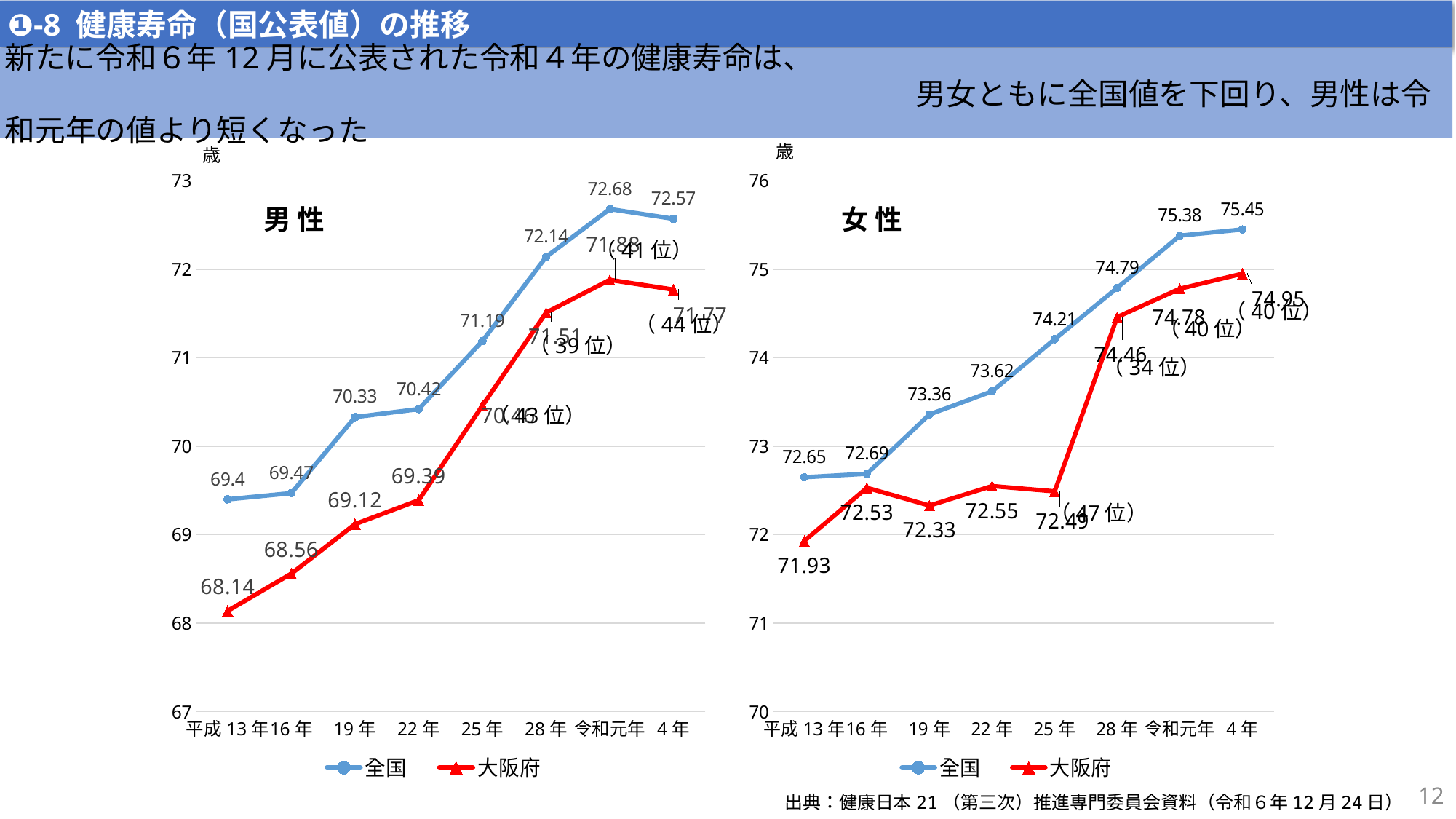
How many years are plotted along the x axis of the 男性 chart? 8 In the 男性 chart, what is the difference between the 全国 and 大阪府 values for 4年? 0.80 In the 男性 chart, what is the 大阪府 value for 平成13年? 68.14 In the 男性 chart, what is the 全国 value for 令和元年? 72.68 In the 女性 chart, which is larger for 25年: the 全国 value or the 大阪府 value? 全国 In the 女性 chart, what is the 全国 value for 28年? 74.79 In the 女性 chart, what is the 大阪府 value for 4年? 74.95 How many series does the legend of the 女性 chart list? 2 In the 女性 chart, is the 大阪府 value for 22年 greater or less than 73? less What kind of chart is the 男性 chart? line chart In the 男性 chart, which year has the highest 全国 value? 令和元年 In the 女性 chart, which year has the lowest 大阪府 value? 平成13年